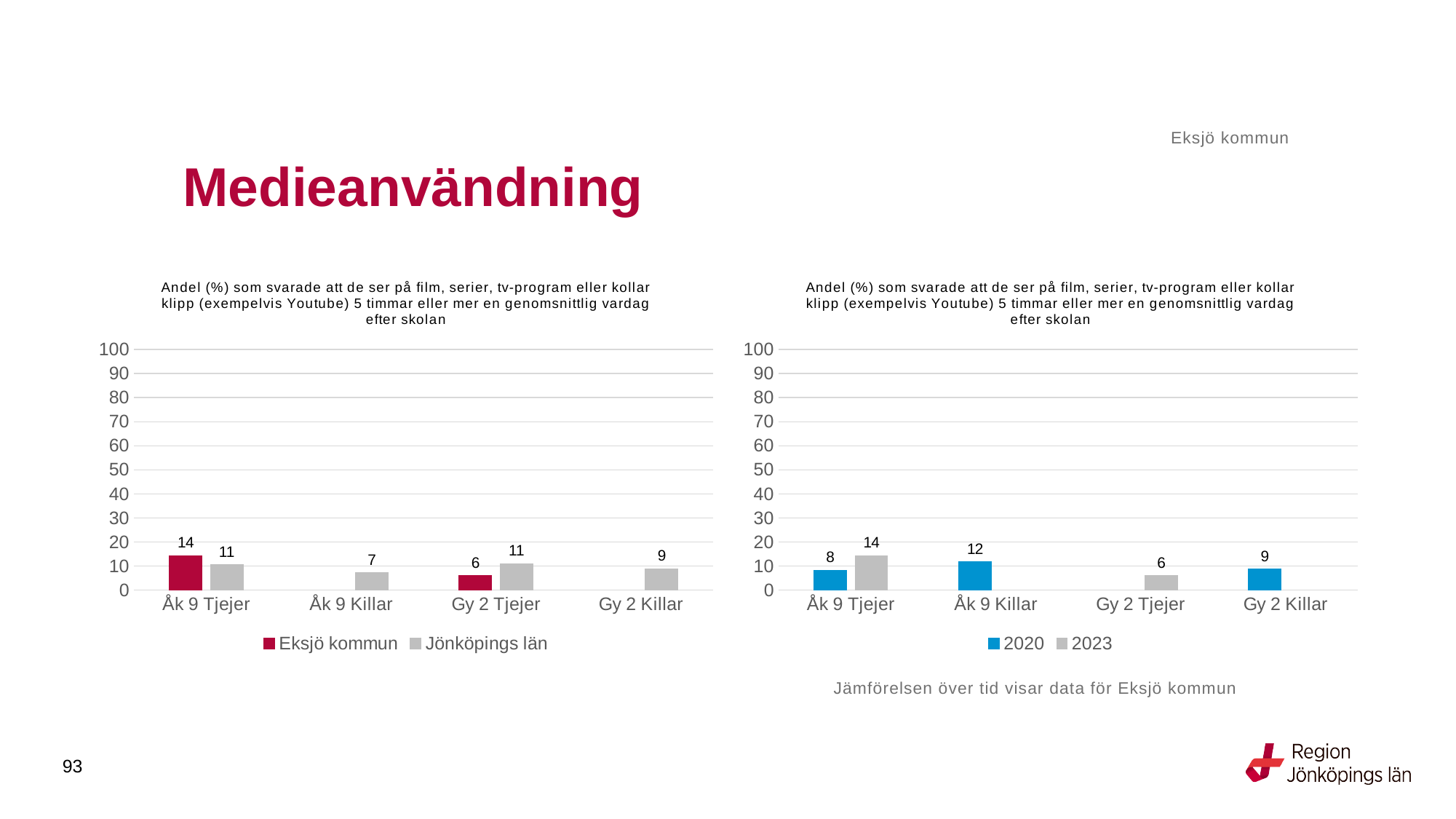
In the right chart, is the value for 2020 for Gy 2 Killar greater or less than 10? less In the left chart, what is the value for Eksjö kommun for Åk 9 Tjejer? 14 In the left chart, what is the difference between Jönköpings län and Eksjö kommun for Gy 2 Tjejer? 5 In the right chart, what is the value for 2023 for Åk 9 Tjejer? 14 What kind of chart is the right chart? Bar chart In the right chart, what is the difference between 2023 and 2020 for Åk 9 Tjejer? 6 In the right chart, what is the value for 2020 for Åk 9 Killar? 12 How many series does the legend of the left chart list? 2 In the left chart, which category has the highest value for Jönköpings län? Åk 9 Tjejer and Gy 2 Tjejer (both 11) In the left chart, which is larger for Åk 9 Tjejer: Eksjö kommun or Jönköpings län? Eksjö kommun In the left chart, what is the value for Jönköpings län for Åk 9 Killar? 7 How many categories are shown on the x axis of the right chart? 4